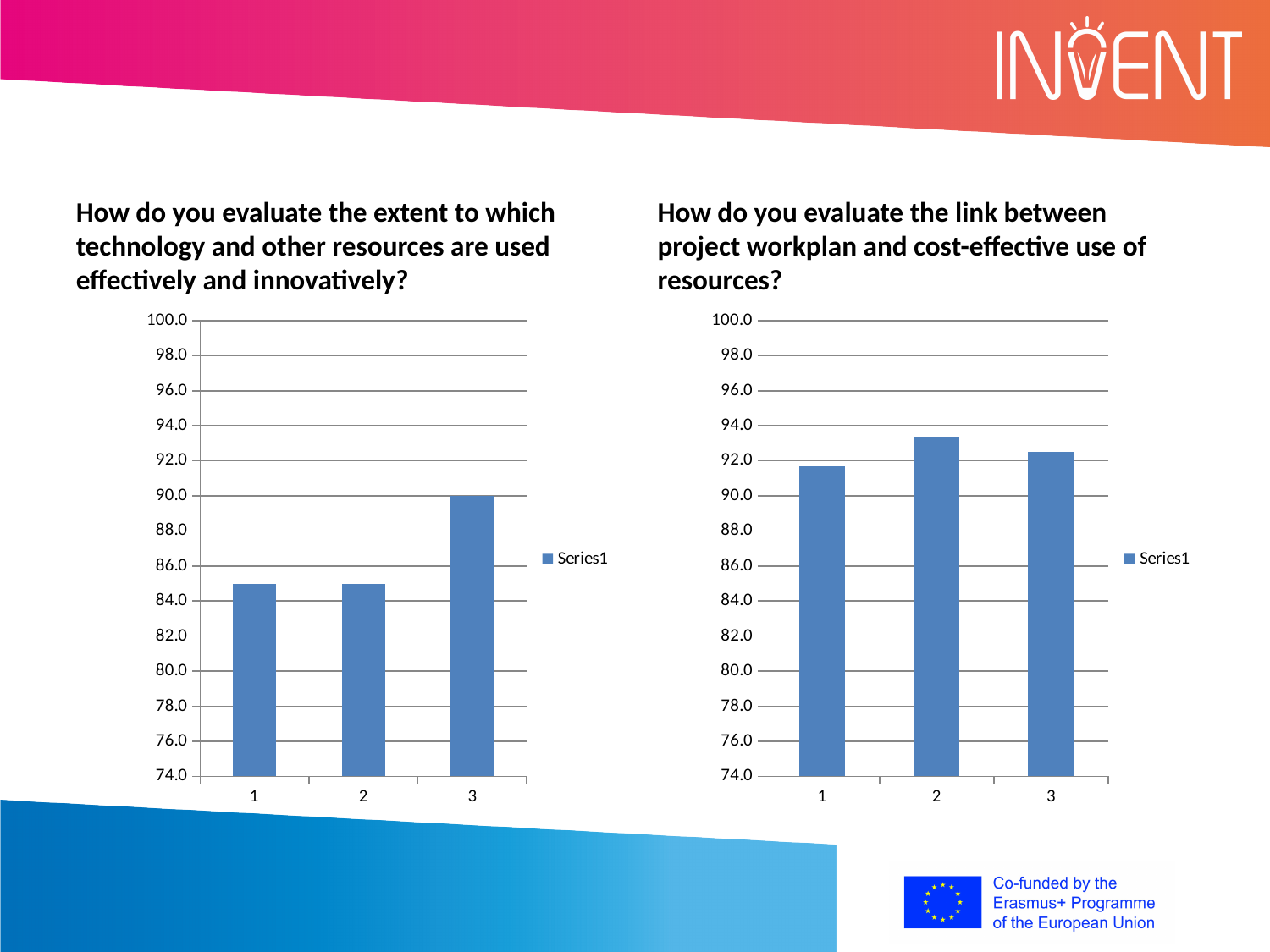
On the right chart (project workplan and cost-effective use of resources), which category has the lowest value? 1 On the left chart (technology and other resources), which is larger, the value for category 1 or category 3? category 3 What kind of chart is the right chart (project workplan and cost-effective use of resources)? bar chart On the right chart (project workplan and cost-effective use of resources), is the value for category 1 greater or less than 92.0? less On the right chart (project workplan and cost-effective use of resources), how many series does the legend list? 1 On the left chart (technology and other resources), is the value for category 1 greater or less than 84.0? greater On the left chart (technology and other resources), which category has the highest value? 3 On the left chart (technology and other resources), what is the value for category 3? 90.0 On the left chart (technology and other resources), is the value for category 2 greater or less than 86.0? less On the right chart (project workplan and cost-effective use of resources), which category has the highest value? 2 On the left chart (technology and other resources), how many categories are shown on the x axis? 3